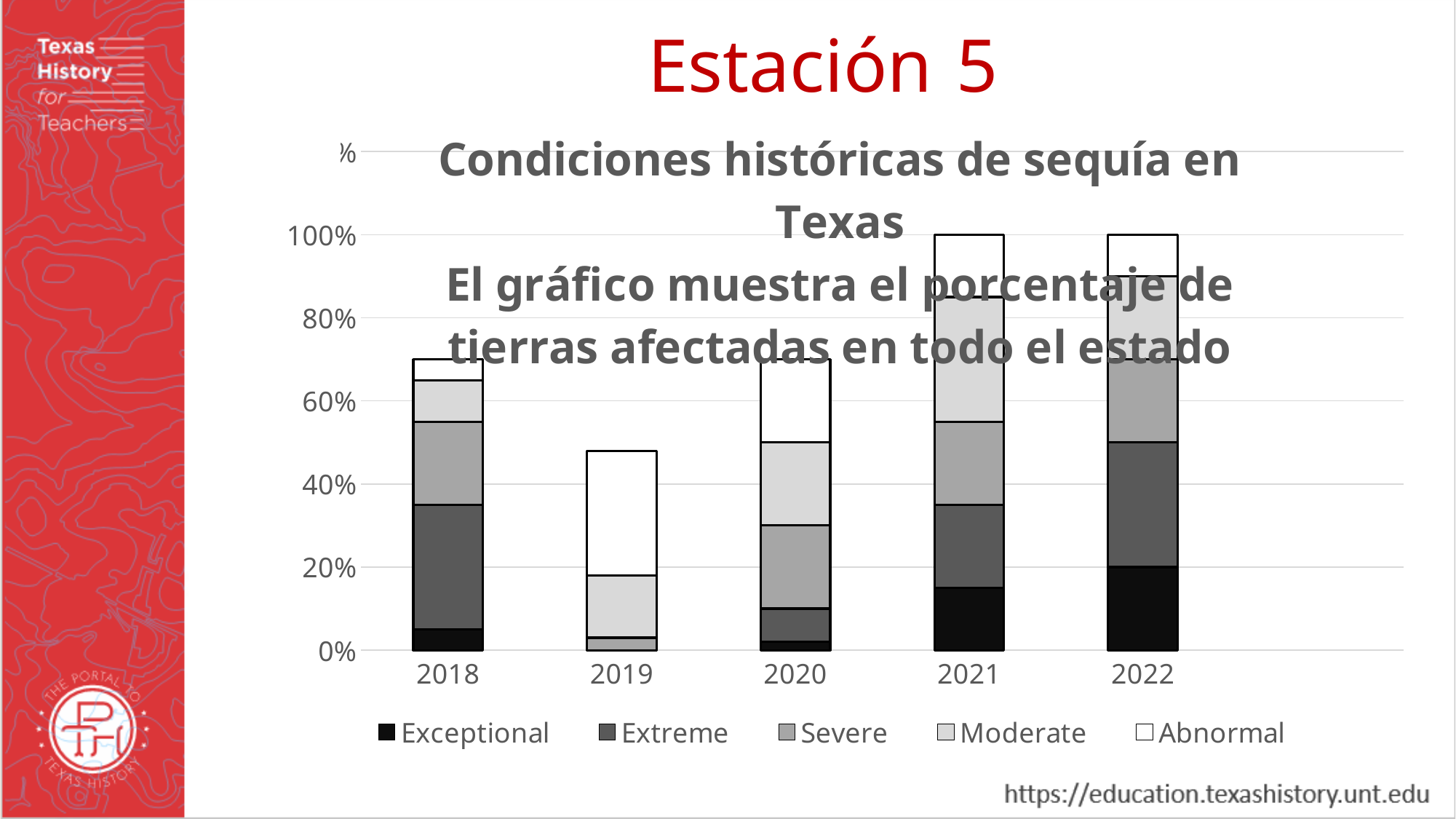
How many years are shown on the x axis of the chart? 5 What is the total height of the stacked bar for 2022? 100% Do the total bar heights rise or fall from 2019 to 2022? rise Which year has a taller total bar, 2018 or 2019? 2018 How many series does the chart's legend list? 5 Which year has the lowest total bar height in the chart? 2019 Which legend entry is shown with a black fill? Exceptional What kind of chart is shown on the slide? Stacked bar chart Is the total bar height for 2018 greater or less than 60%? greater Is the Exceptional segment for 2022 greater or less than 40%? less What is the total height of the stacked bar for 2021? 100% Is the total bar height for 2019 greater or less than 60%? less